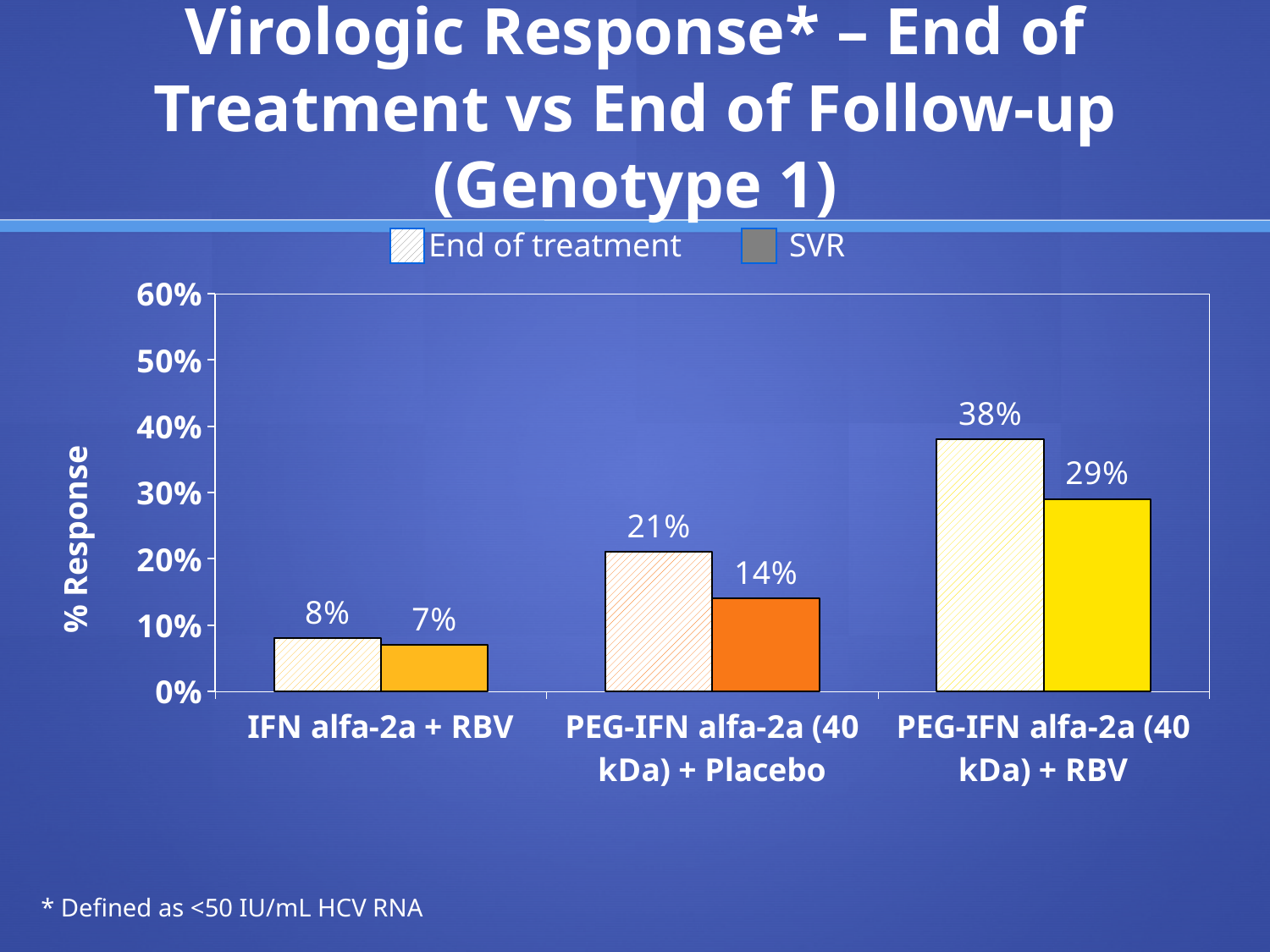
What is the SVR value for PEG-IFN alfa-2a (40 kDa) + Placebo? 14% What is the difference between the End of treatment values for PEG-IFN alfa-2a (40 kDa) + Placebo and IFN alfa-2a + RBV? 13% How many series does the legend list? 2 Which treatment group has the highest SVR value? PEG-IFN alfa-2a (40 kDa) + RBV What is the SVR value for IFN alfa-2a + RBV? 7% What kind of chart is shown on the slide? Bar chart What is the End of treatment value for PEG-IFN alfa-2a (40 kDa) + RBV? 38% What is the difference between the End of treatment and SVR values for PEG-IFN alfa-2a (40 kDa) + RBV? 9% Is the End of treatment value for PEG-IFN alfa-2a (40 kDa) + RBV greater or less than 30%? greater Which treatment group has the lowest End of treatment value? IFN alfa-2a + RBV Which is larger: the SVR value for PEG-IFN alfa-2a (40 kDa) + RBV or the End of treatment value for PEG-IFN alfa-2a (40 kDa) + Placebo? SVR value for PEG-IFN alfa-2a (40 kDa) + RBV How many treatment groups are shown on the x axis? 3